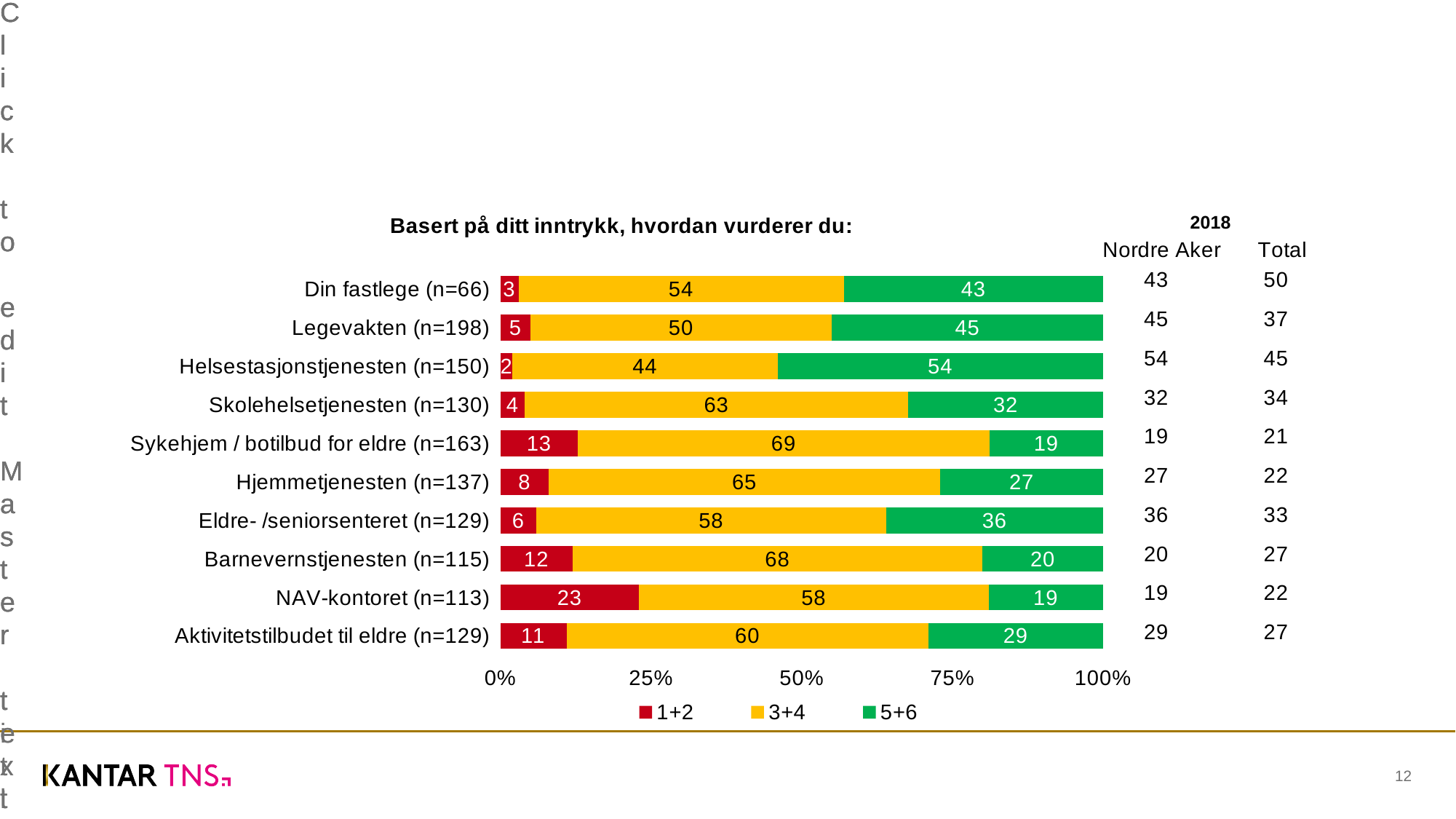
Which has a larger 3+4 value, Skolehelsetjenesten (n=130) or Hjemmetjenesten (n=137)? Hjemmetjenesten (n=137) How many categories are shown in the chart? 10 How many series does the legend list? 3 What is the difference between the 5+6 values for Legevakten (n=198) and Din fastlege (n=66)? 2 What is the value of the 3+4 segment for Sykehjem / botilbud for eldre (n=163)? 69 Which category has the highest 5+6 value? Helsestasjonstjenesten (n=150) What type of chart is shown on the slide? Stacked bar chart Which category has the highest 1+2 value? NAV-kontoret (n=113) What is the total of the stacked bar for Din fastlege (n=66)? 100 What is the value of the 1+2 segment for NAV-kontoret (n=113)? 23 What is the value of the 5+6 segment for Helsestasjonstjenesten (n=150)? 54 Which category has the lowest 1+2 value? Helsestasjonstjenesten (n=150)